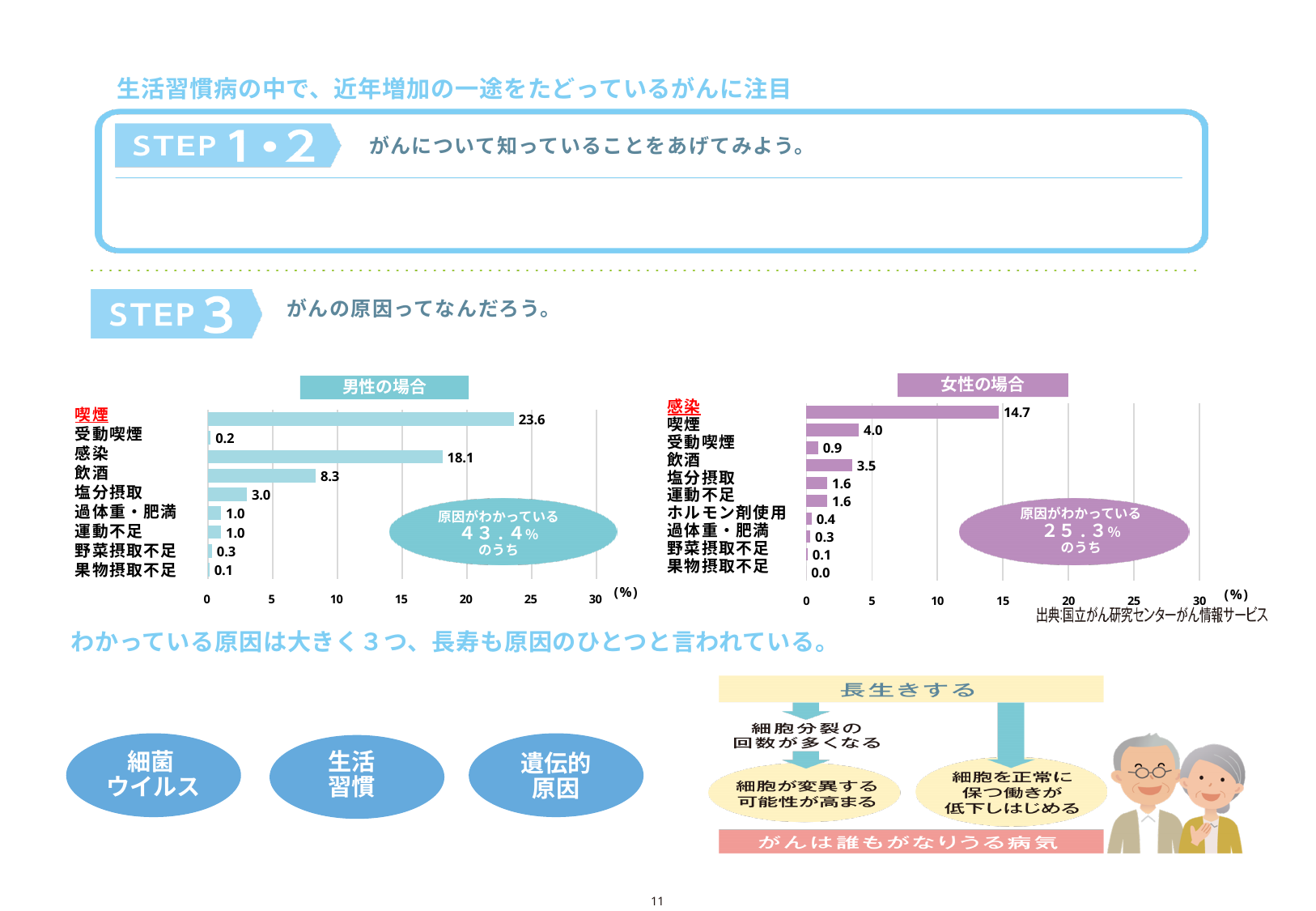
What type of chart is the 男性の場合 chart? Bar chart How many categories are shown in the 女性の場合 chart? 10 In the 女性の場合 chart, what is the difference between 感染 and 喫煙? 10.7 In the 男性の場合 chart, which category has the highest value? 喫煙 In the 男性の場合 chart, what is the value for 感染? 18.1 In the 男性の場合 chart, what is the value for 喫煙? 23.6 In the 女性の場合 chart, what is the value for 飲酒? 3.5 In the 男性の場合 chart, which is larger, 飲酒 or 塩分摂取? 飲酒 In the 女性の場合 chart, what is the value for 感染? 14.7 In the 男性の場合 chart, what is the difference between 喫煙 and 感染? 5.5 How many categories are shown in the 男性の場合 chart? 9 In the 女性の場合 chart, which category has the lowest value? 果物摂取不足